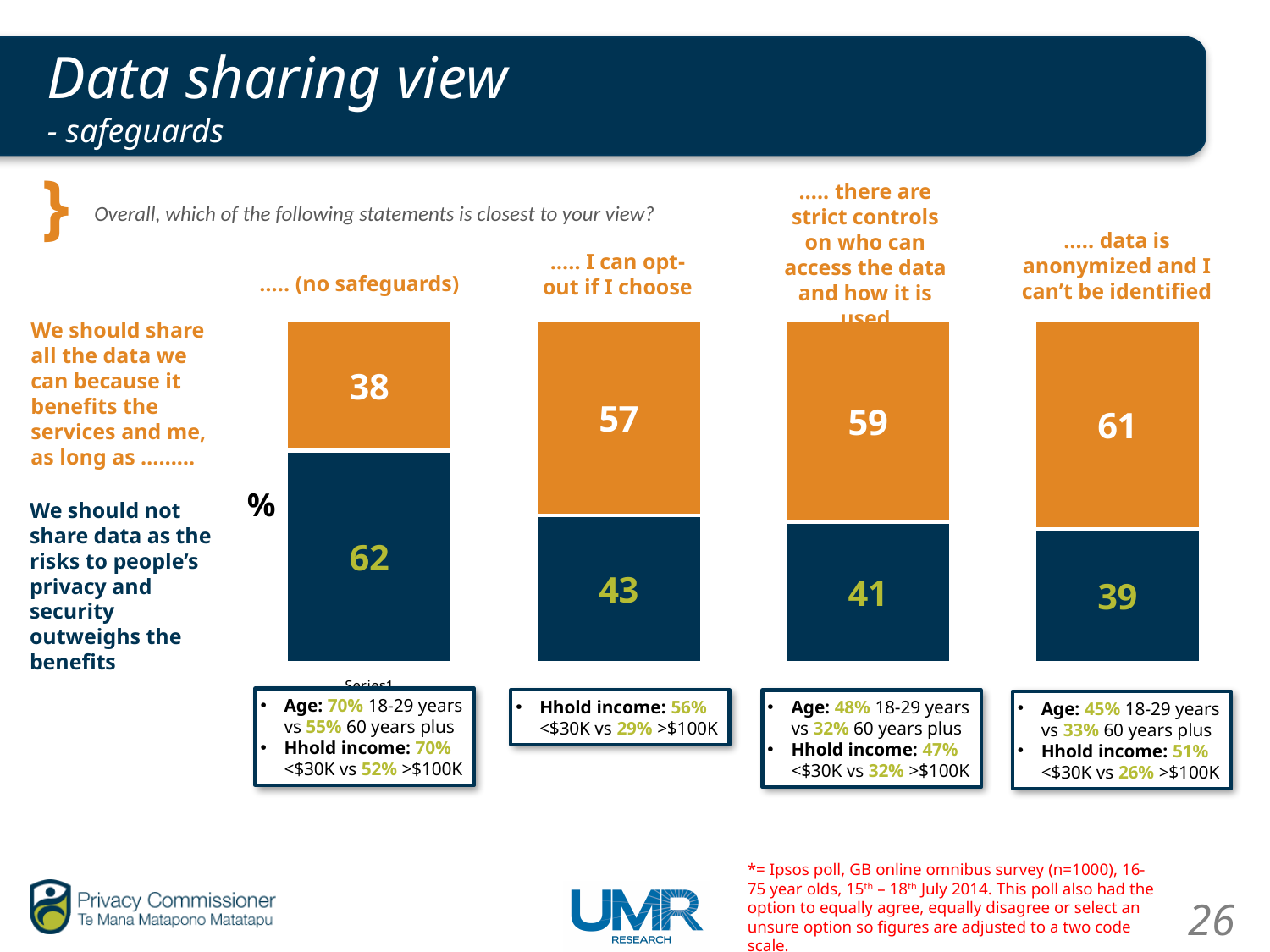
What percentage of respondents say we should not share data under the 'I can opt-out if I choose' condition? 43 How many safeguard conditions (bars) are shown on the slide? 4 Does the 'share all the data' percentage rise or fall moving from the no safeguards bar to the anonymized data bar? rise Under which condition is the share of respondents saying we should share all the data highest? data is anonymized and I can't be identified What is the difference between the 'should not share' percentage under no safeguards and under the opt-out condition? 19 Which is larger: the 'share all the data' percentage under strict controls or under the opt-out condition? strict controls What percentage of respondents say we should share all the data we can when there are strict controls on who can access the data and how it is used? 59 Under which condition is the share of respondents saying we should share all the data lowest? (no safeguards) What percentage of respondents say we should not share data when data is anonymized and they can't be identified? 39 What is the total of the two segments in the 'I can opt-out if I choose' bar? 100 What percentage of respondents say we should share all the data we can under the '(no safeguards)' condition? 38 What type of chart is used to show the data sharing views? stacked bar chart